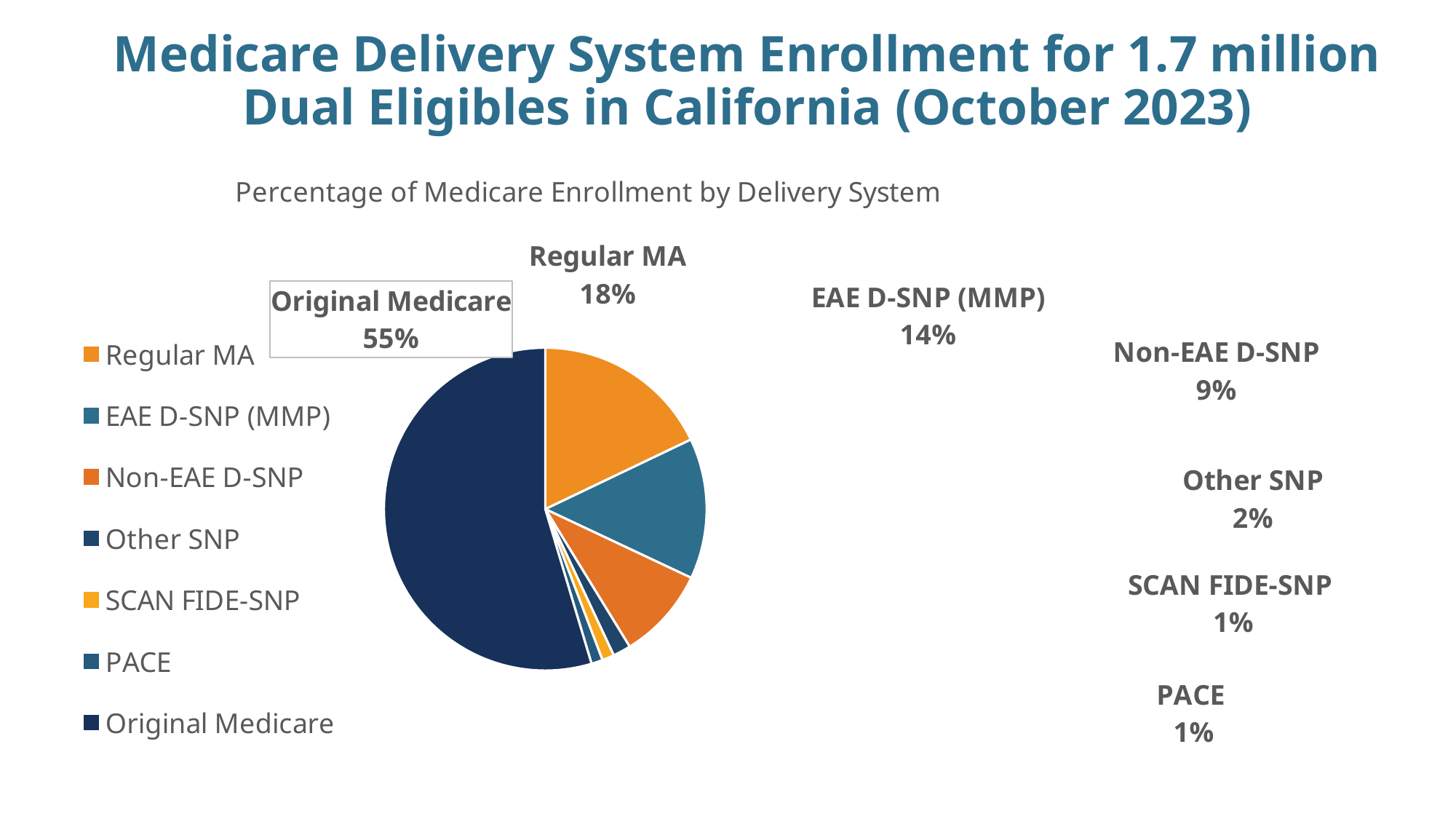
What is the combined share of SCAN FIDE-SNP and PACE? 2% How many delivery system categories are shown in the pie chart? 7 What kind of chart is shown on the slide? Pie chart What percentage of Medicare enrollment is EAE D-SNP (MMP)? 14% What percentage of Medicare enrollment is Other SNP? 2% What is the difference in percentage points between Regular MA and EAE D-SNP (MMP)? 4 What is the chart's title? Percentage of Medicare Enrollment by Delivery System Which delivery system has the largest share of Medicare enrollment? Original Medicare What percentage of Medicare enrollment is Regular MA? 18% What percentage of Medicare enrollment is Non-EAE D-SNP? 9% Which has a larger share of enrollment, Non-EAE D-SNP or Other SNP? Non-EAE D-SNP What percentage of Medicare enrollment is Original Medicare? 55%